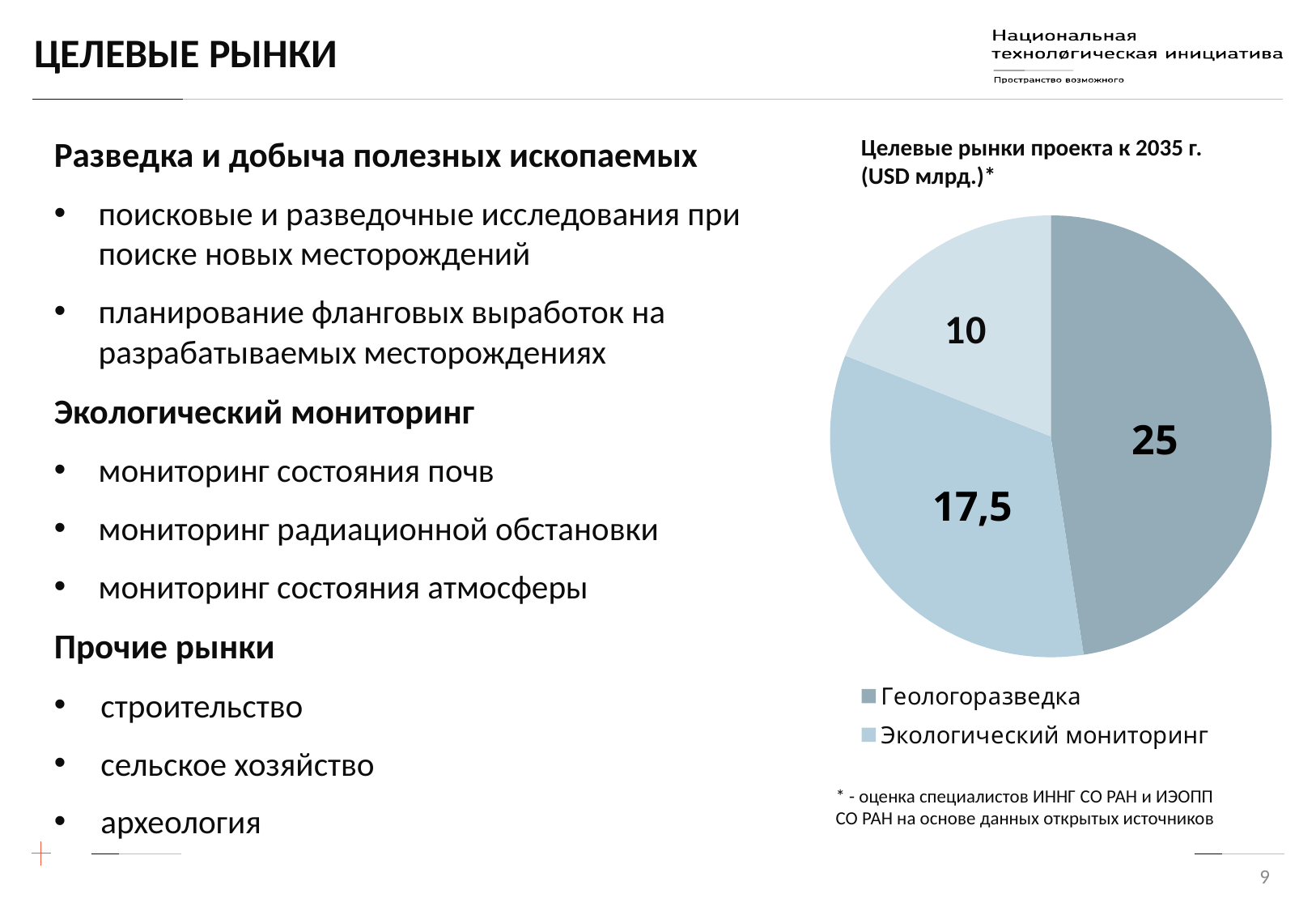
What is the difference between the largest and the smallest slice values in the pie chart? 15 What is the value for Экологический мониторинг in the pie chart? 17,5 How many entries does the chart legend list? 2 What is the title of the pie chart? Целевые рынки проекта к 2035 г. (USD млрд.)* What is the smallest value labelled on the pie chart? 10 How many slices does the pie chart have? 3 What kind of chart is shown on the slide? pie chart What is the sum of all the values labelled on the pie chart? 52,5 Which is larger, Геологоразведка or Экологический мониторинг? Геологоразведка Which legend category has the largest slice in the pie chart? Геологоразведка What is the value for Геологоразведка in the pie chart? 25 What is the difference between the values for Геологоразведка and Экологический мониторинг? 7,5